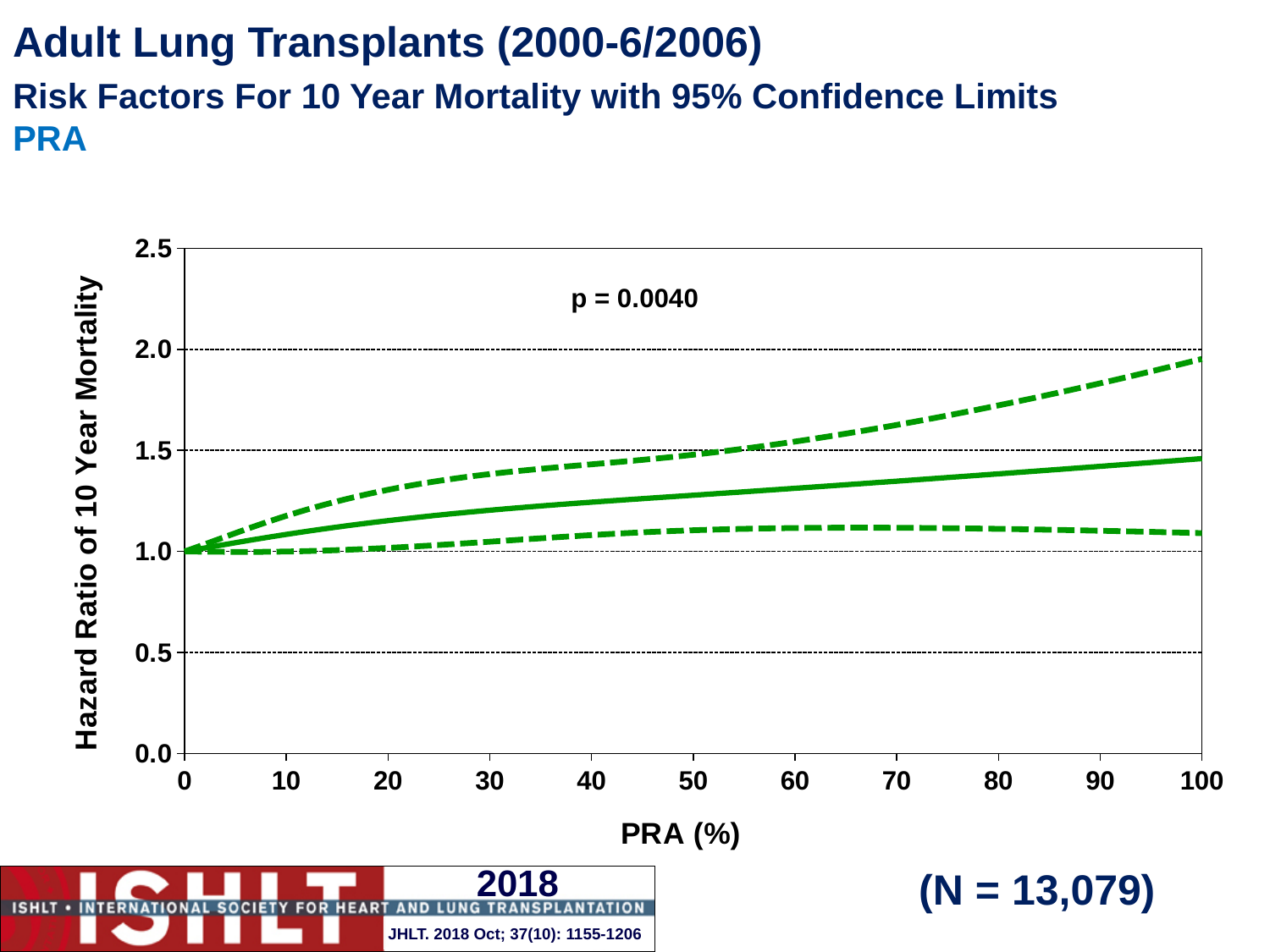
What is the label of the x axis? PRA (%) What is the p-value shown on the chart? p = 0.0040 Is the value of the upper dashed confidence limit at PRA 100 greater or less than 1.5? greater At PRA 100, which is larger: the upper dashed confidence limit or the solid hazard ratio line? the upper dashed confidence limit Is the value of the lower dashed confidence limit at PRA 100 greater or less than 1.5? less What is the hazard ratio of the solid line at PRA 0? 1.0 Is the value of the solid hazard ratio line at PRA 50 greater or less than 1.5? less Does the solid hazard ratio line rise or fall as PRA increases from 0 to 100? rise What kind of chart is shown on the slide? line chart How many lines are plotted on the chart? 3